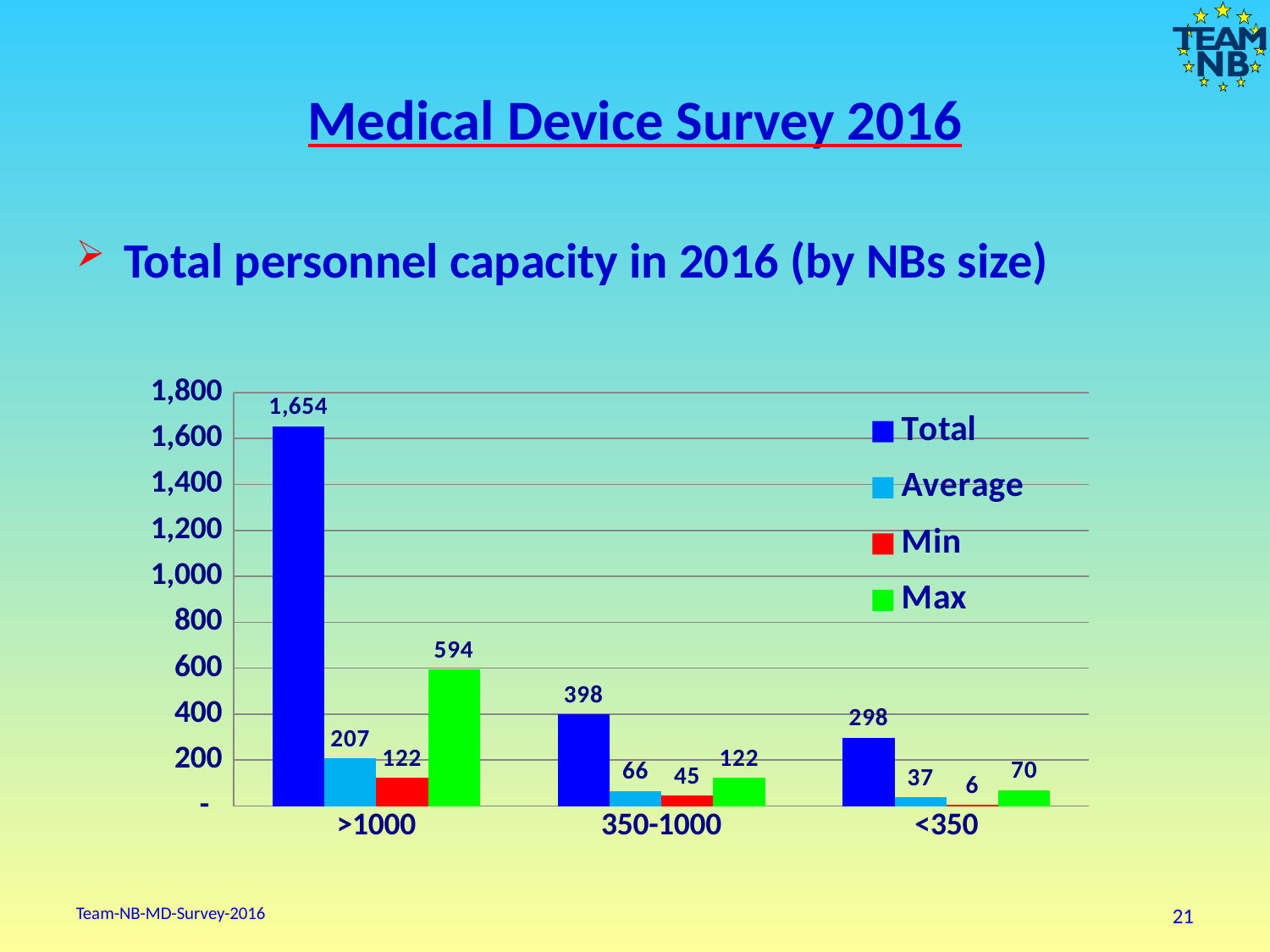
What is the Min value for the <350 category? 6 Which category has the lowest Min value? <350 What is the Average value for the <350 category? 37 What is the Max value for the 350-1000 category? 122 What is the Total value for the >1000 category? 1,654 Which series is shown in green in the legend? Max How many series does the legend list? 4 What kind of chart is shown on the slide? Bar chart What is the difference between the Total values for 350-1000 and <350? 100 Which is larger, the Max value for >1000 or the Total value for 350-1000? Max value for >1000 How many categories are shown on the x axis? 3 Which category has the highest Total value? >1000